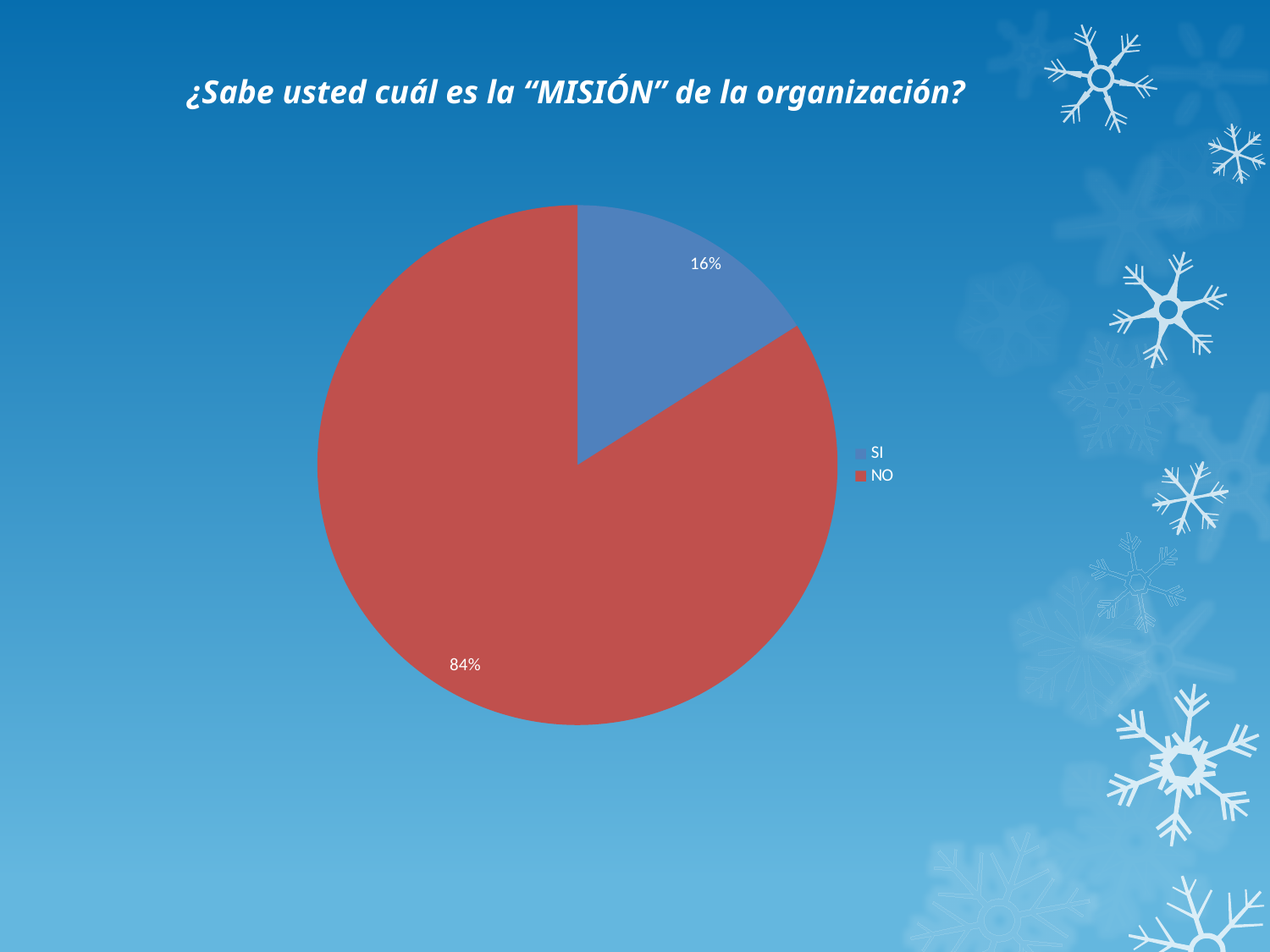
What kind of chart is shown on the slide? Pie chart Which slice is larger, SI or NO? NO How many categories are shown in the pie chart? 2 What percentage of respondents answered SI? 16% What is the title of the chart on the slide? ¿Sabe usted cuál es la "MISIÓN" de la organización? Which category has the smallest share of the pie? SI What percentage of respondents answered NO? 84% Which category has the largest share of the pie? NO What is the difference in percentage points between the NO and SI slices? 68 What share of the pie does the SI slice represent? 16% What colour is the NO slice of the pie? Red